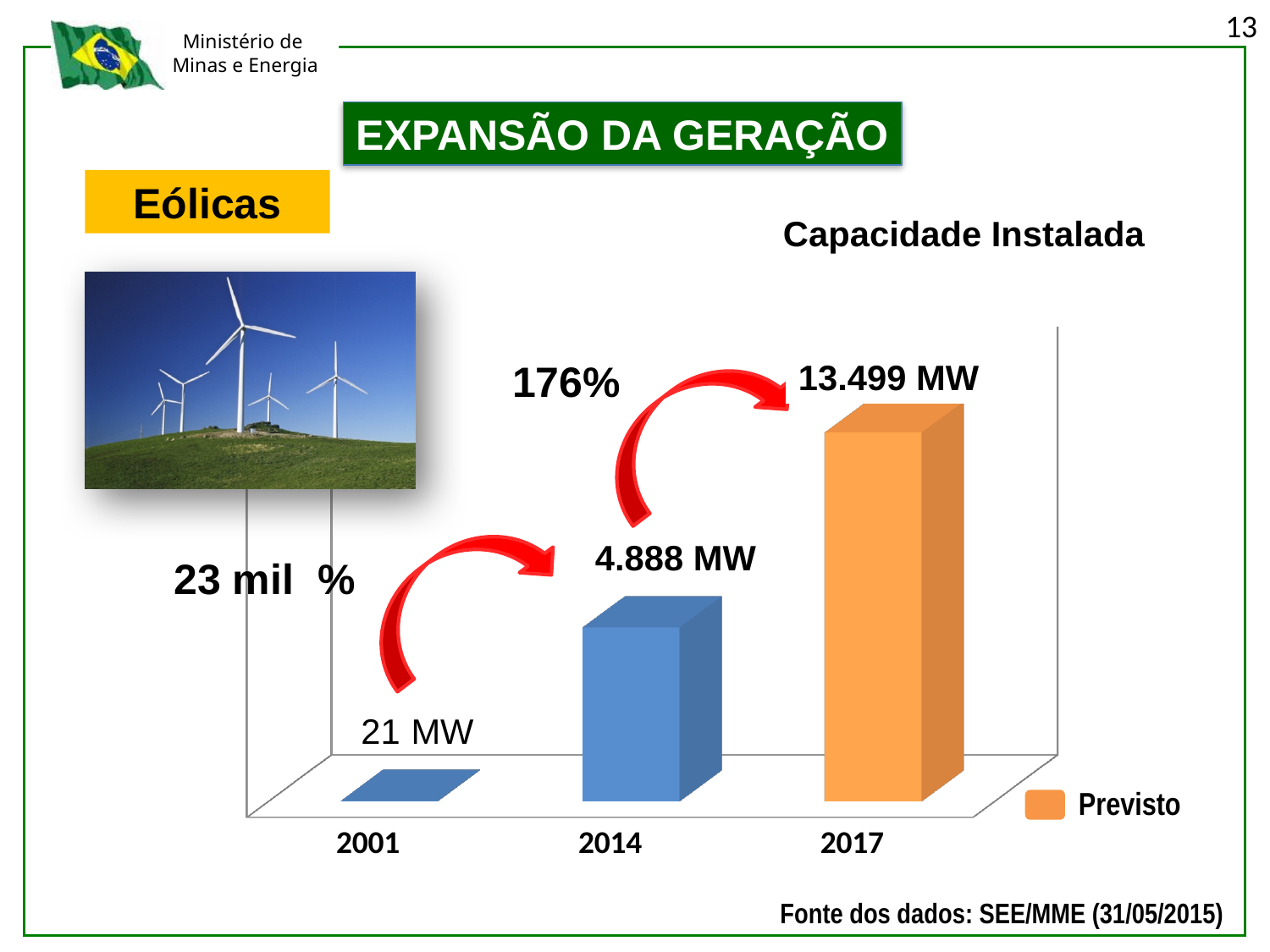
Do the values rise or fall from 2001 to 2017? Rise Which year has the highest installed capacity on the chart? 2017 What label does the legend give to the orange bar? Previsto What is the installed capacity shown for 2017? 13.499 MW How many years (bars) are shown on the chart? 3 What is the installed capacity shown for 2014? 4.888 MW What is the installed capacity shown for 2001? 21 MW Which is larger, the value for 2014 or the value for 2017? 2017 What is the difference between the 2014 and 2001 values? 4.867 MW What kind of chart is shown on the slide? Bar chart What is the difference between the 2017 and 2014 values? 8.611 MW Which year has the lowest installed capacity on the chart? 2001